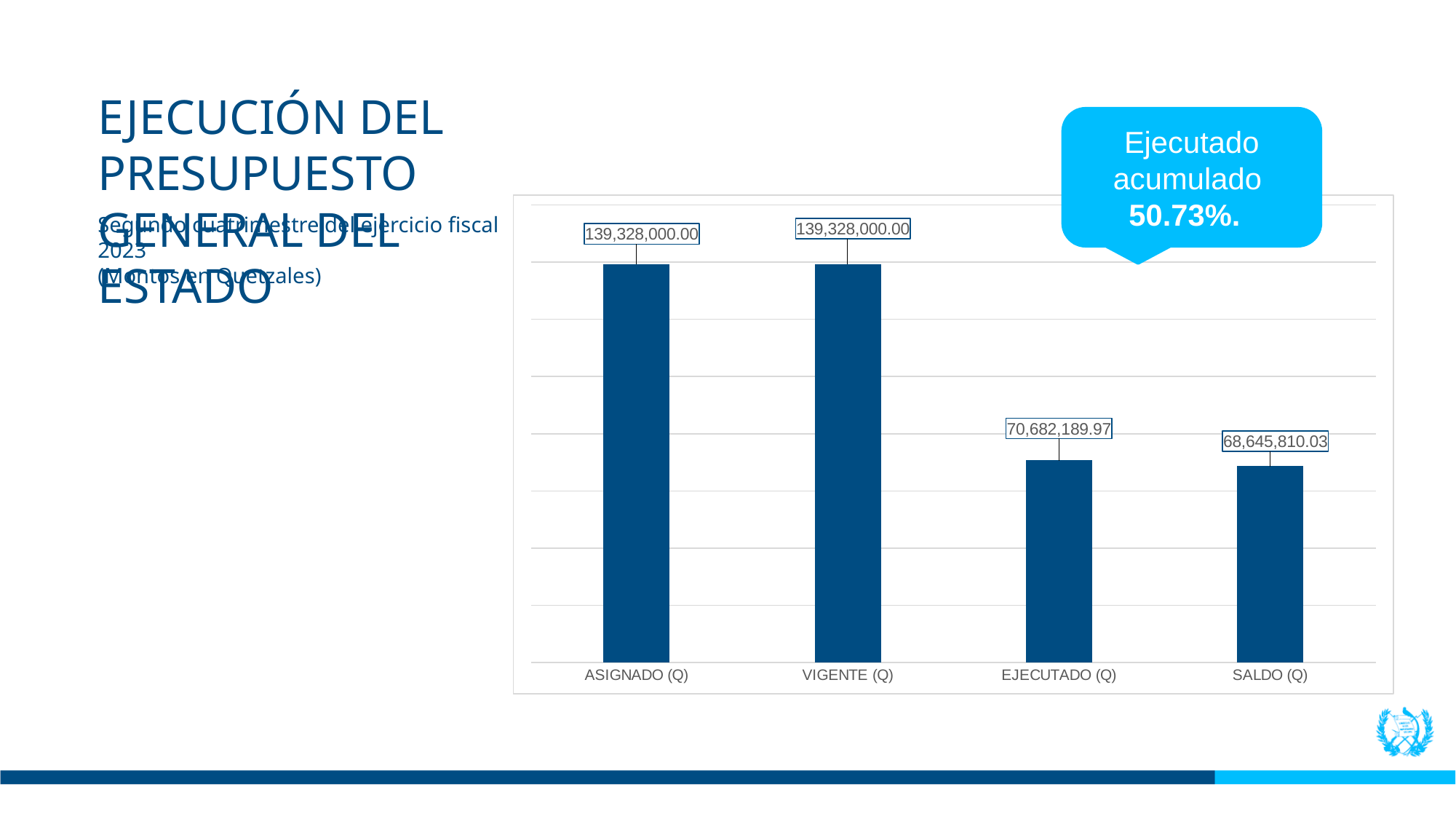
How many categories are shown on the x axis? 4 Which is larger, the value for EJECUTADO (Q) or the value for SALDO (Q)? EJECUTADO (Q) Which category has the lowest value? SALDO (Q) What kind of chart is shown on the slide? Bar chart What is the value for VIGENTE (Q)? 139,328,000.00 What is the difference between the values for ASIGNADO (Q) and EJECUTADO (Q)? 68,645,810.03 What is the difference between the values for EJECUTADO (Q) and SALDO (Q)? 2,036,379.94 What is the value for ASIGNADO (Q)? 139,328,000.00 Do the values rise or fall from VIGENTE (Q) to SALDO (Q) along the x axis? Fall What is the value for SALDO (Q)? 68,645,810.03 What accumulated execution percentage is shown in the callout next to the chart? 50.73% What is the value for EJECUTADO (Q)? 70,682,189.97